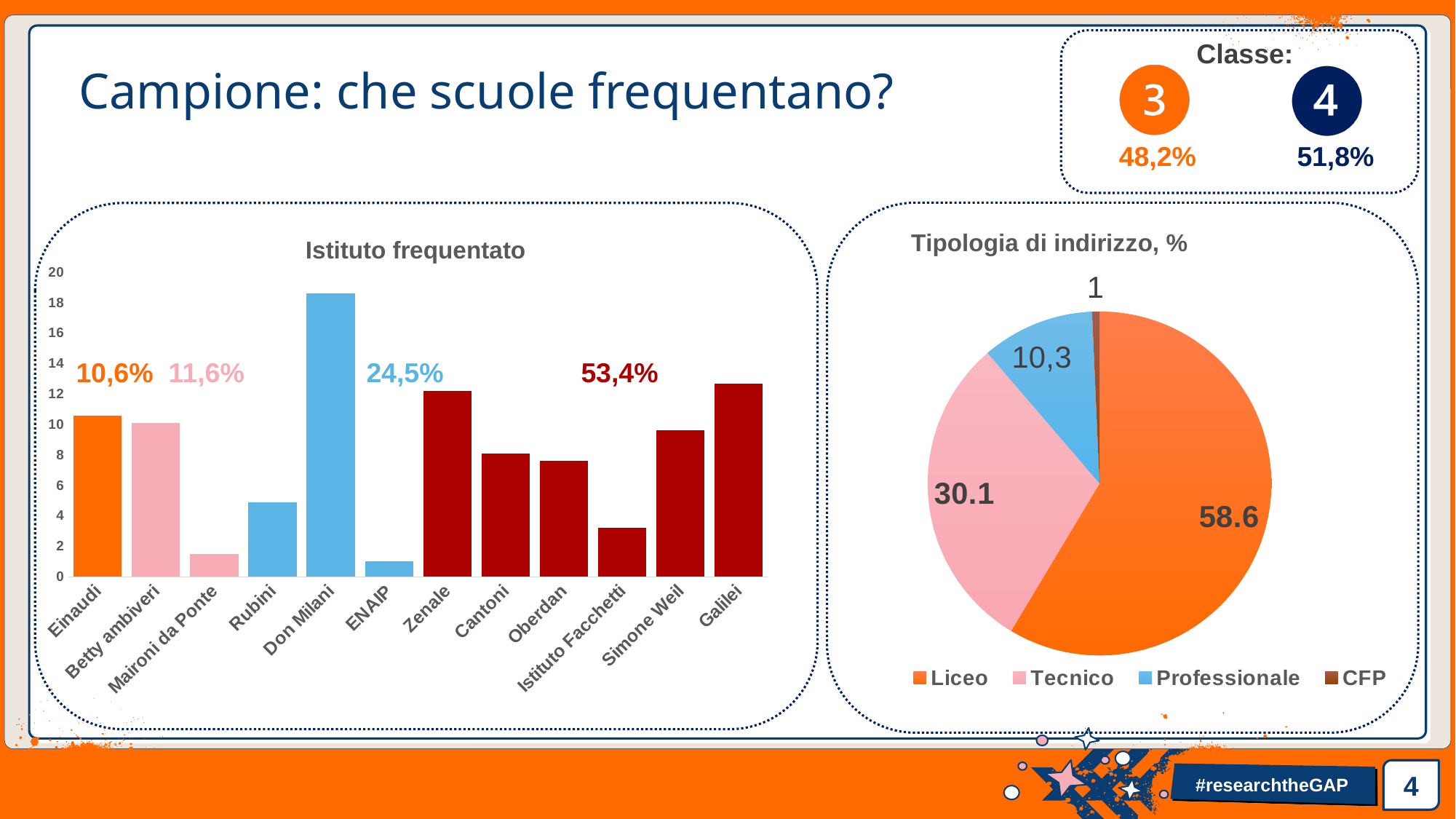
In the pie chart 'Tipologia di indirizzo, %', what is the difference between the values for Liceo and Tecnico? 28.5 In the bar chart 'Istituto frequentato', which institute has the highest bar? Don Milani In the bar chart 'Istituto frequentato', which has the larger value, Galilei or Cantoni? Galilei In the pie chart 'Tipologia di indirizzo, %', what is the value for Tecnico? 30.1 In the bar chart 'Istituto frequentato', is the value for Maironi da Ponte greater or less than 4? less In the pie chart 'Tipologia di indirizzo, %', which category has the largest slice? Liceo In the pie chart 'Tipologia di indirizzo, %', which category has the smallest slice? CFP What kind of chart is 'Istituto frequentato'? bar chart How many entries does the legend of the pie chart 'Tipologia di indirizzo, %' list? 4 How many institutes are shown on the x axis of the bar chart 'Istituto frequentato'? 12 In the pie chart 'Tipologia di indirizzo, %', what is the value for Liceo? 58.6 In the bar chart 'Istituto frequentato', is the value for Don Milani greater or less than 16? greater